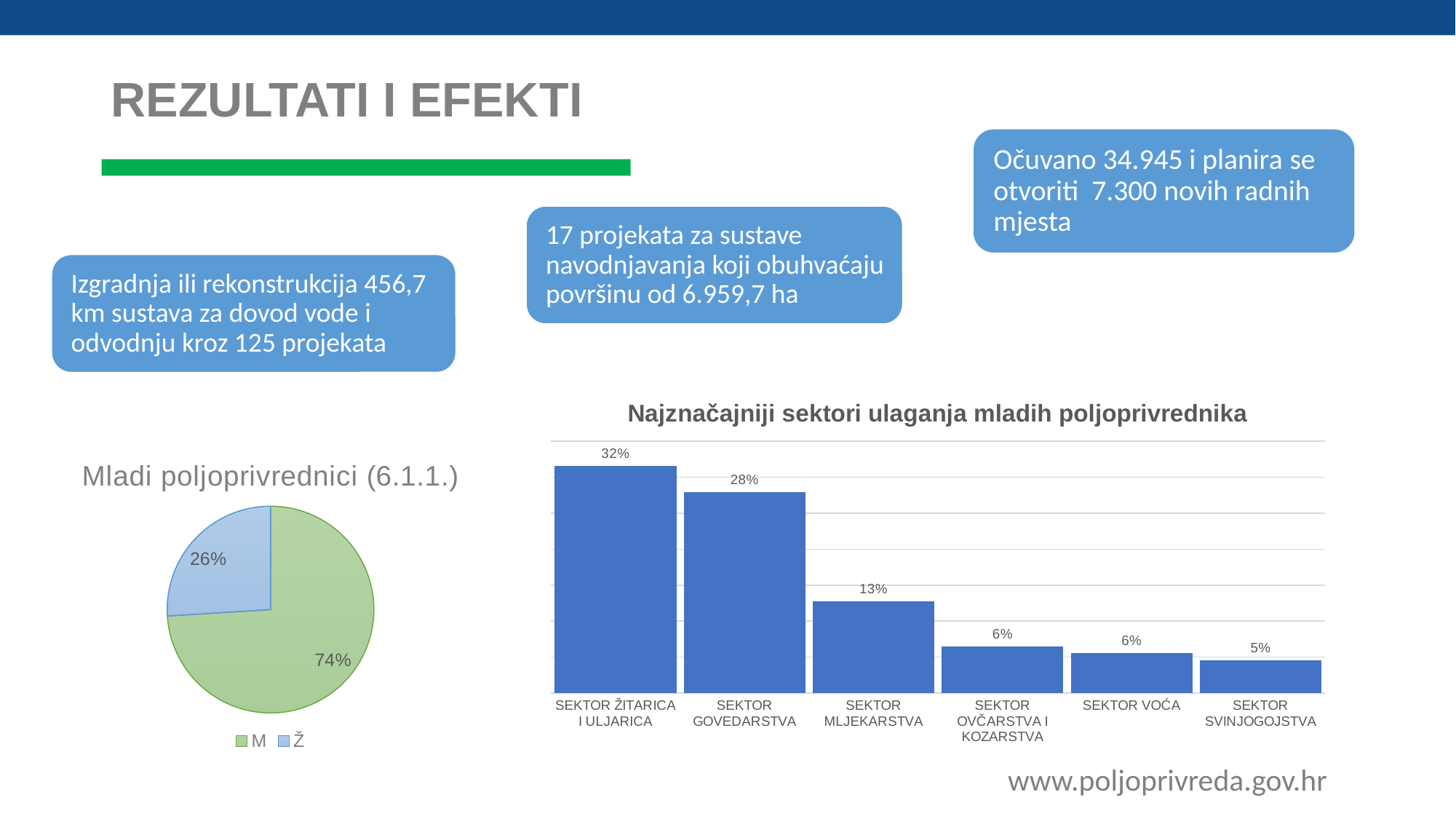
In the 'Mladi poljoprivrednici (6.1.1.)' pie chart, what share does Ž have? 26% In the 'Najznačajniji sektori ulaganja mladih poljoprivrednika' chart, what is the difference between SEKTOR ŽITARICA I ULJARICA and SEKTOR GOVEDARSTVA? 4% In the 'Najznačajniji sektori ulaganja mladih poljoprivrednika' chart, what is the value for SEKTOR GOVEDARSTVA? 28% How many entries does the legend of the 'Mladi poljoprivrednici (6.1.1.)' chart list? 2 In the 'Najznačajniji sektori ulaganja mladih poljoprivrednika' chart, which sector has the highest value? SEKTOR ŽITARICA I ULJARICA How many sectors are shown in the 'Najznačajniji sektori ulaganja mladih poljoprivrednika' chart? 6 In the 'Mladi poljoprivrednici (6.1.1.)' pie chart, what share does M have? 74% What kind of chart is 'Najznačajniji sektori ulaganja mladih poljoprivrednika'? Bar chart What kind of chart is 'Mladi poljoprivrednici (6.1.1.)'? Pie chart In the 'Najznačajniji sektori ulaganja mladih poljoprivrednika' chart, what is the value for SEKTOR MLJEKARSTVA? 13% In the 'Najznačajniji sektori ulaganja mladih poljoprivrednika' chart, which sector has the lowest value? SEKTOR SVINJOGOJSTVA In the 'Mladi poljoprivrednici (6.1.1.)' pie chart, which slice is larger, M or Ž? M